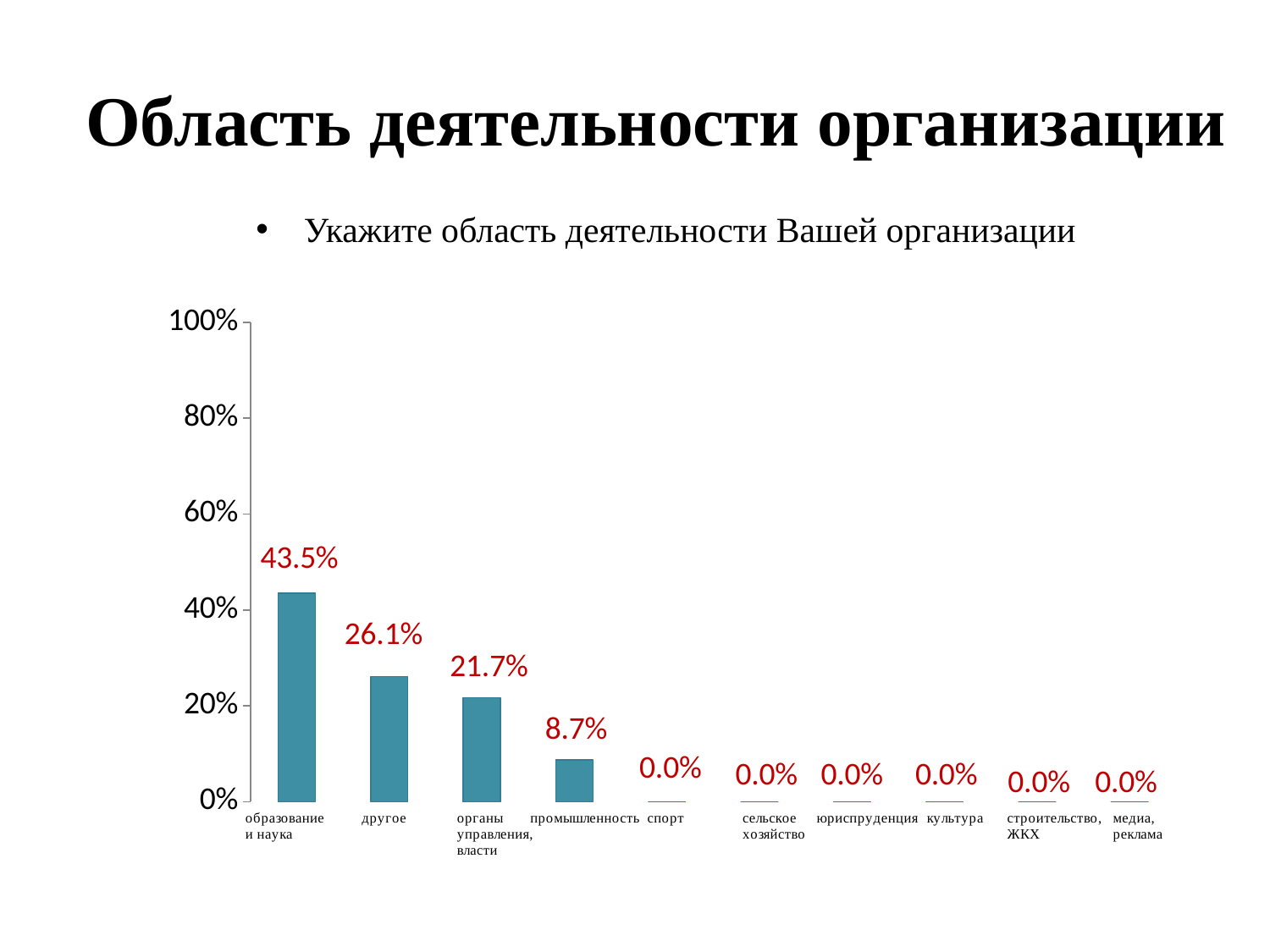
What is the value for органы управления, власти? 21.7% What kind of chart is shown on the slide? bar chart Which category has the highest value? образование и наука How many categories have a value of 0.0%? 6 What is the difference between the values for образование и наука and другое? 17.4% What is the difference between the values for органы управления, власти and промышленность? 13.0% Which is larger, the value for другое or the value for органы управления, власти? другое What is the value for культура? 0.0% How many categories are shown on the x axis? 10 What is the value for промышленность? 8.7% What is the value for образование и наука? 43.5% What is the value for другое? 26.1%